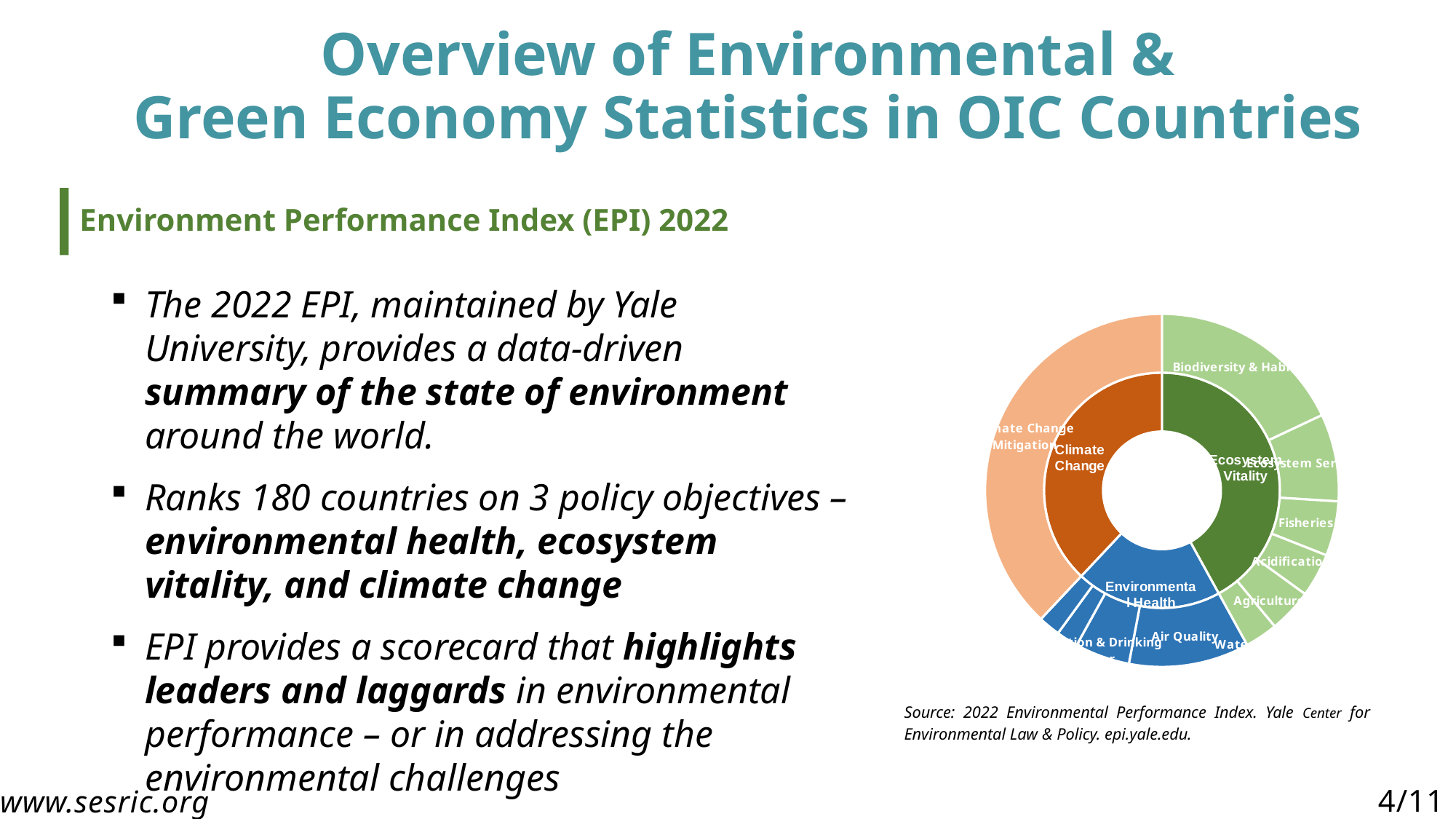
Which policy objective in the inner ring of the chart has the smallest segment? Environmental Health How many policy objectives are shown in the inner ring of the chart? 3 In the inner ring of the chart, which segment is larger: Climate Change or Environmental Health? Climate Change Which outer-ring segment sits under the Climate Change policy objective in the chart? Climate Change Mitigation Among the outer-ring segments under Ecosystem Vitality, which is the largest? Biodiversity & Habitat Which policy objective does the Fisheries segment belong to in the chart? Ecosystem Vitality What kind of chart is shown on the slide? Doughnut (sunburst) chart Which policy objective does the Air Quality segment belong to in the chart? Environmental Health Which colour is used for the Ecosystem Vitality segment in the chart? Green In the inner ring of the chart, which segment is larger: Ecosystem Vitality or Environmental Health? Ecosystem Vitality